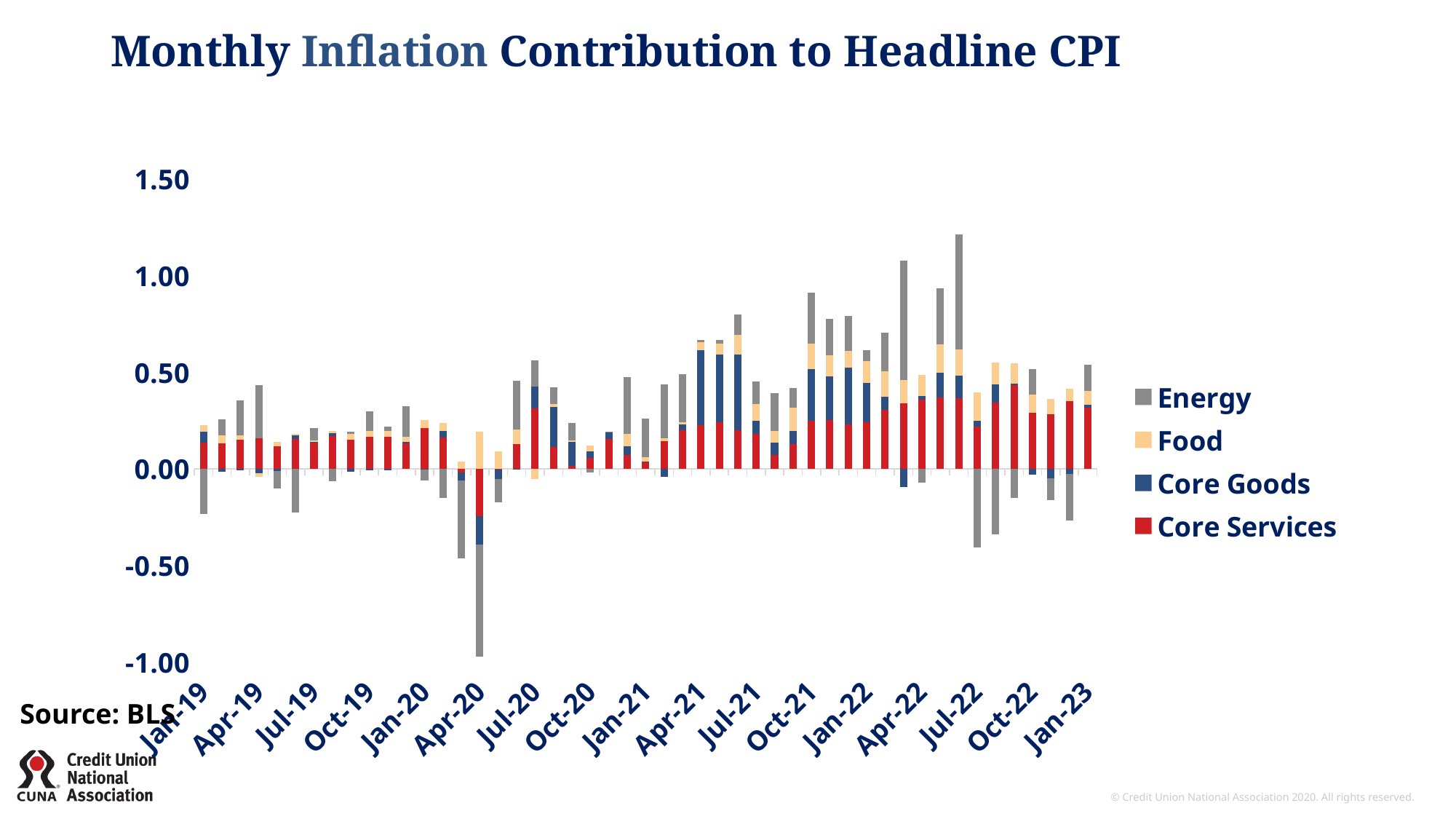
What is the source cited for the chart? BLS Is the top of the Jan-19 bar greater or less than 0.50? less Is the lowest point of the Apr-20 bar greater or less than -0.50? less What is the highest value shown on the y axis? 1.50 Which series is shown in red in the legend? Core Services How many series does the legend list? 4 Is the top of the Oct-20 bar greater or less than 0.50? less Which labelled month has the largest negative Energy contribution? Apr-20 How many month labels are shown along the x axis? 17 What kind of chart is shown on the slide? Stacked bar chart